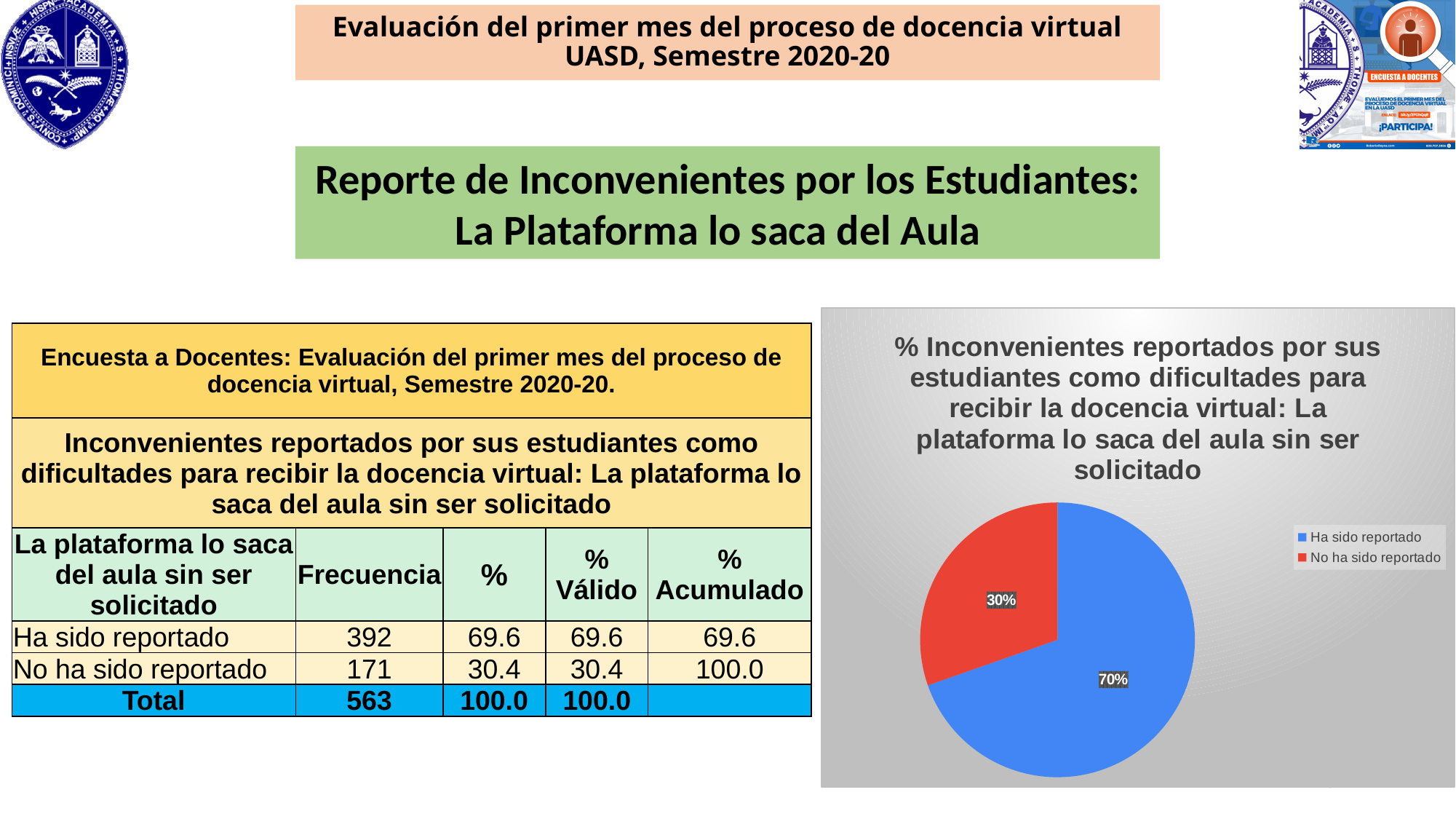
How many entries does the pie chart legend list? 2 What colour is the "No ha sido reportado" slice in the pie chart? red Which slice is larger in the pie chart, "Ha sido reportado" or "No ha sido reportado"? Ha sido reportado Which category has the largest slice in the pie chart? Ha sido reportado What is the difference in percentage points between the "Ha sido reportado" and "No ha sido reportado" slices in the pie chart? 40% What percentage does the pie chart show for "Ha sido reportado"? 70% What colour is the "Ha sido reportado" slice in the pie chart? blue How many slices does the pie chart have? 2 Which category has the smallest slice in the pie chart? No ha sido reportado What percentage does the pie chart show for "No ha sido reportado"? 30% What kind of chart is shown on the slide? pie chart What share of the pie does the "No ha sido reportado" slice represent? 30%